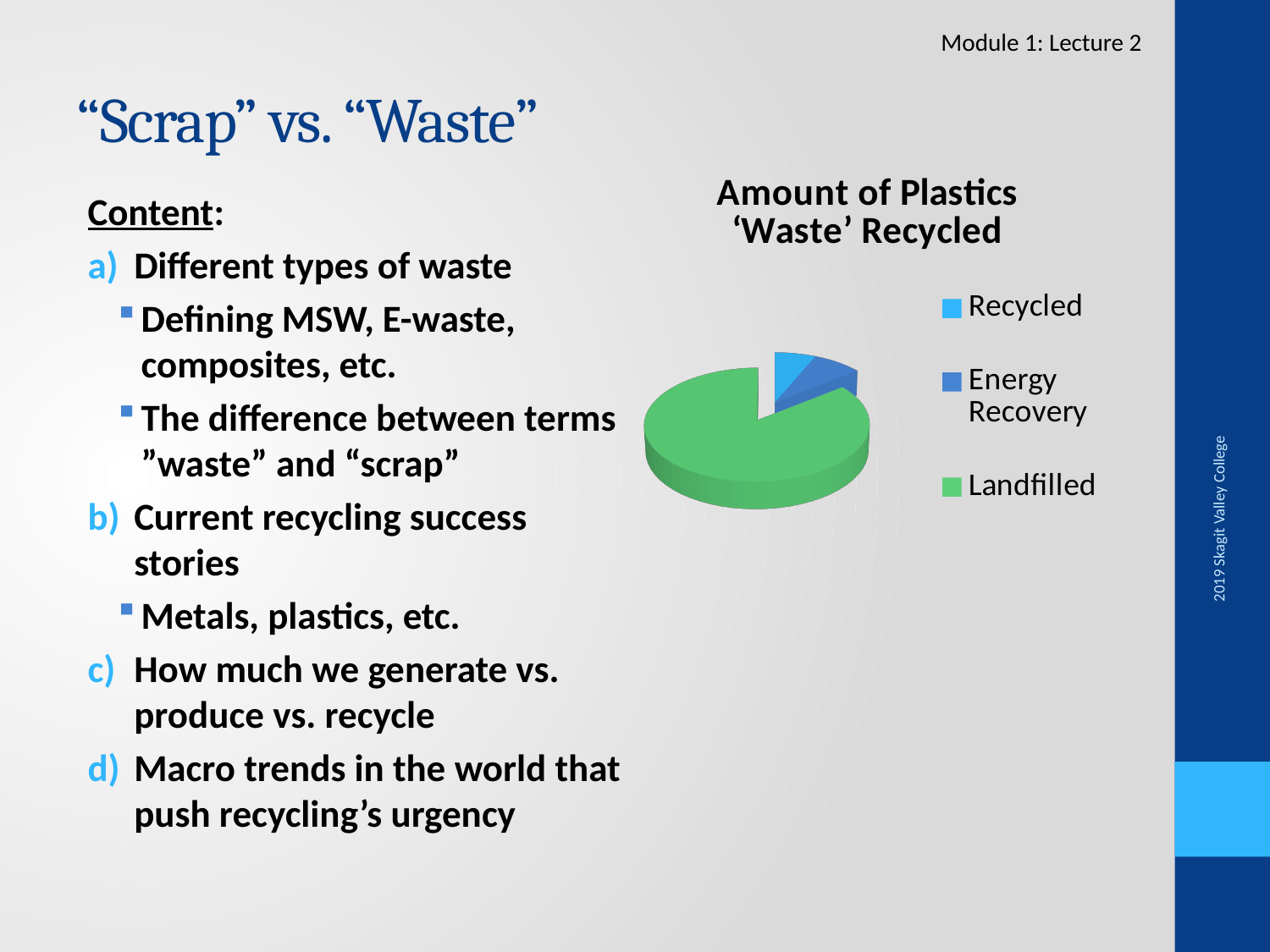
How many categories does the pie chart show? 3 Which is larger in the pie chart, Energy Recovery or Landfilled? Landfilled Which category has the largest slice of the pie chart? Landfilled Which colour represents Landfilled in the pie chart? green What is the title of the chart on the slide? Amount of Plastics 'Waste' Recycled How many entries does the chart's legend list? 3 What kind of chart is shown on the slide? pie chart Which is larger in the pie chart, Landfilled or Recycled? Landfilled